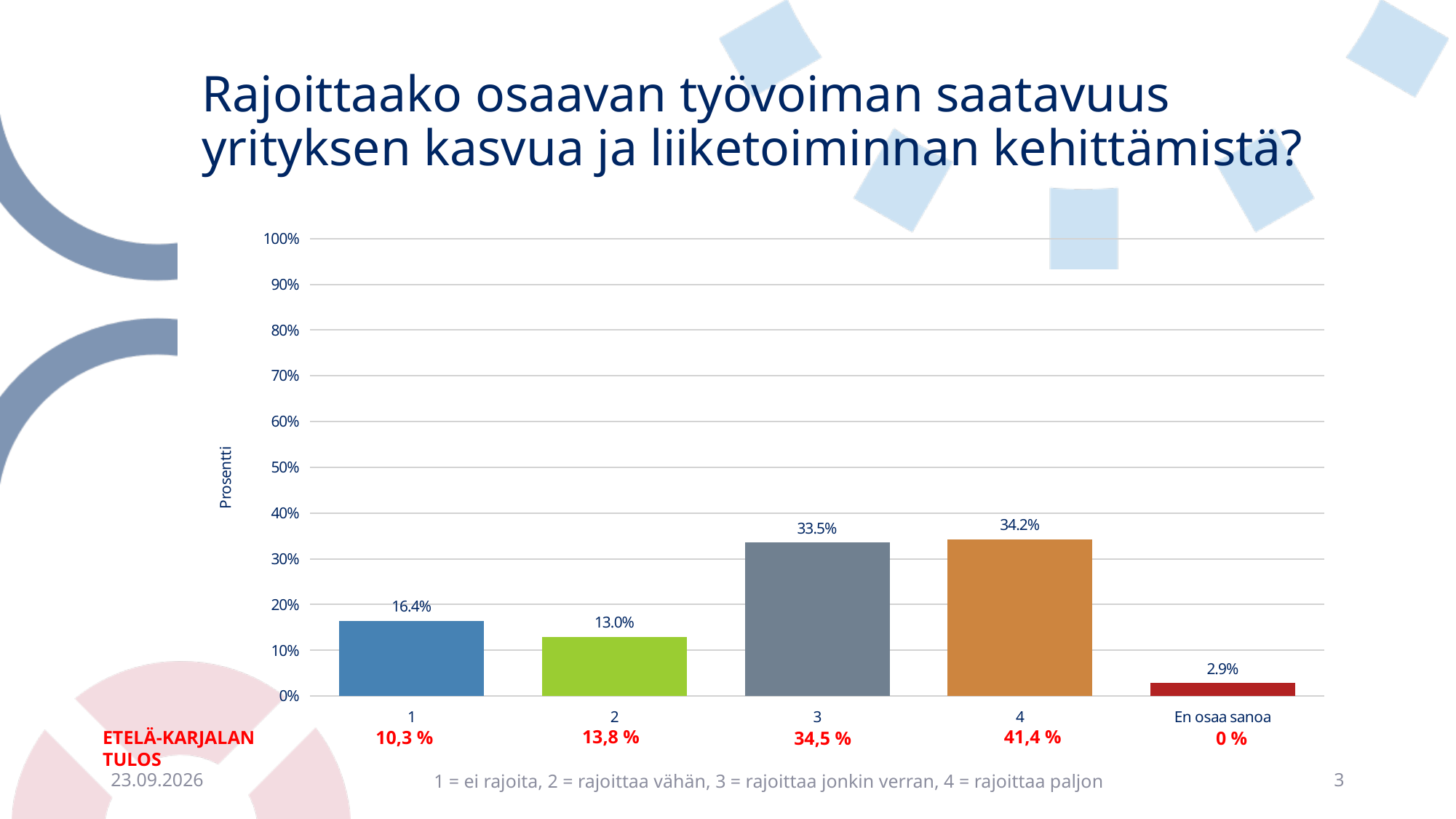
What is the value for "En osaa sanoa"? 2.9% Which is larger, the value for category 1 or category 2? Category 1 What is the difference between the values for category 1 and category 2? 3.4 percentage points Which category has the lowest value? En osaa sanoa How many categories are shown on the x axis? 5 What is the label of the vertical axis? Prosentti Which category has the highest value? 4 What is the value for category 1? 16.4% Is the value for category 3 greater or less than 30%? greater What is the difference between the values for category 4 and category 3? 0.7 percentage points What kind of chart is shown on the slide? Bar chart What is the value for category 3? 33.5%